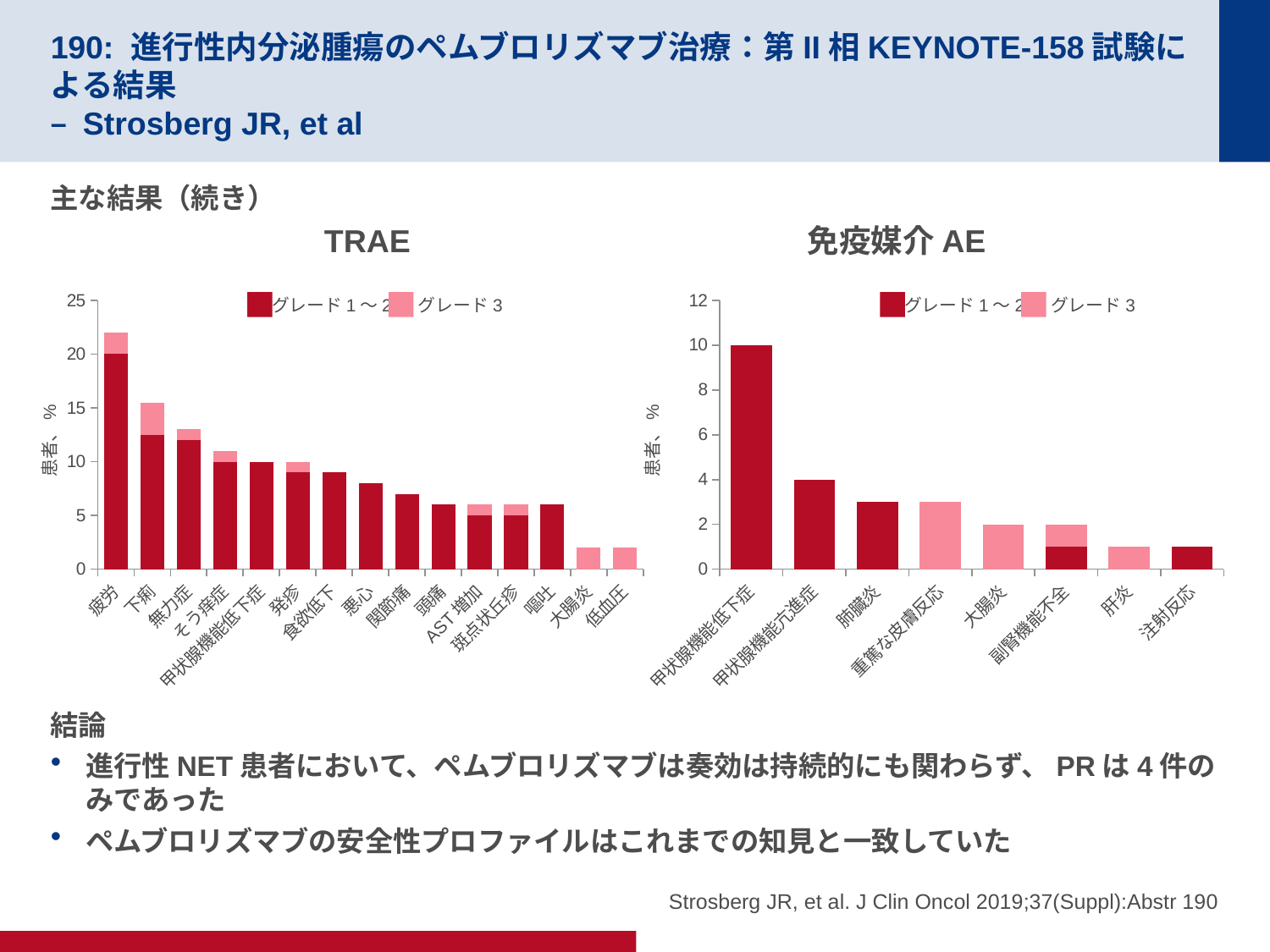
How many categories are shown on the x axis of the TRAE chart? 15 In the TRAE chart, is the total value for 疲労 greater or less than 20? greater In the 免疫媒介 AE chart, which is larger, the bar for 甲状腺機能亢進症 or the bar for 肺臓炎? 甲状腺機能亢進症 In the 免疫媒介 AE chart, is the value for 肺臓炎 greater or less than 4? less How many series does the legend of the TRAE chart list? 2 In the TRAE chart, which category has the highest total bar? 疲労 How many categories are shown on the x axis of the 免疫媒介 AE chart? 8 What kind of chart is the TRAE chart on the left? bar chart In the TRAE chart, do the total bar heights generally rise or fall from left to right along the x axis? fall In the TRAE chart, is the value for 悪心 greater or less than 10? less What is the y-axis label of the 免疫媒介 AE chart? 患者、% In the 免疫媒介 AE chart, which category has the highest bar? 甲状腺機能低下症